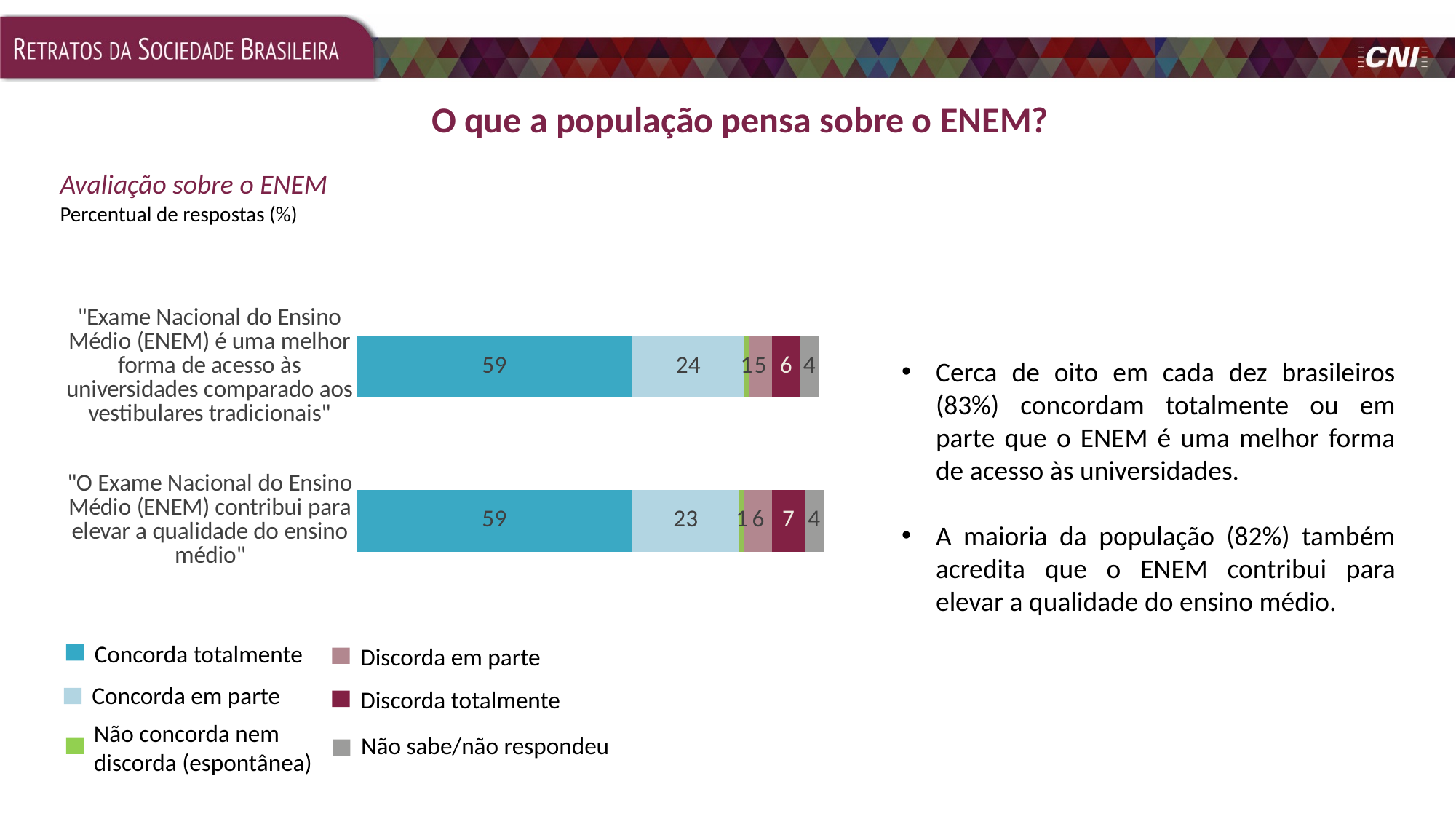
What percentage of respondents 'Concorda totalmente' that the ENEM is a better form of access to universities compared to traditional vestibulares? 59 What is the total of the stacked bar for the statement that the ENEM contributes to raising the quality of secondary education? 100 What kind of chart is shown on the slide? Stacked bar chart What percentage answered 'Não sabe/não respondeu' for the statement that the ENEM is a better form of access to universities? 4 Which response category has the largest share for the statement that the ENEM contributes to raising the quality of secondary education? Concorda totalmente What percentage of respondents 'Discorda totalmente' that the ENEM contributes to raising the quality of secondary education? 7 How many statements (bars) are shown in the chart? 2 How many response categories does the legend list? 6 What percentage of respondents 'Discorda em parte' that the ENEM is a better form of access to universities? 5 What percentage of respondents 'Concorda em parte' that the ENEM contributes to raising the quality of secondary education? 23 Is 'Discorda totalmente' larger for the statement about access to universities or for the statement about quality of secondary education? Quality of secondary education What is the difference between 'Concorda em parte' for the statement about access to universities and 'Concorda em parte' for the statement about quality of secondary education? 1